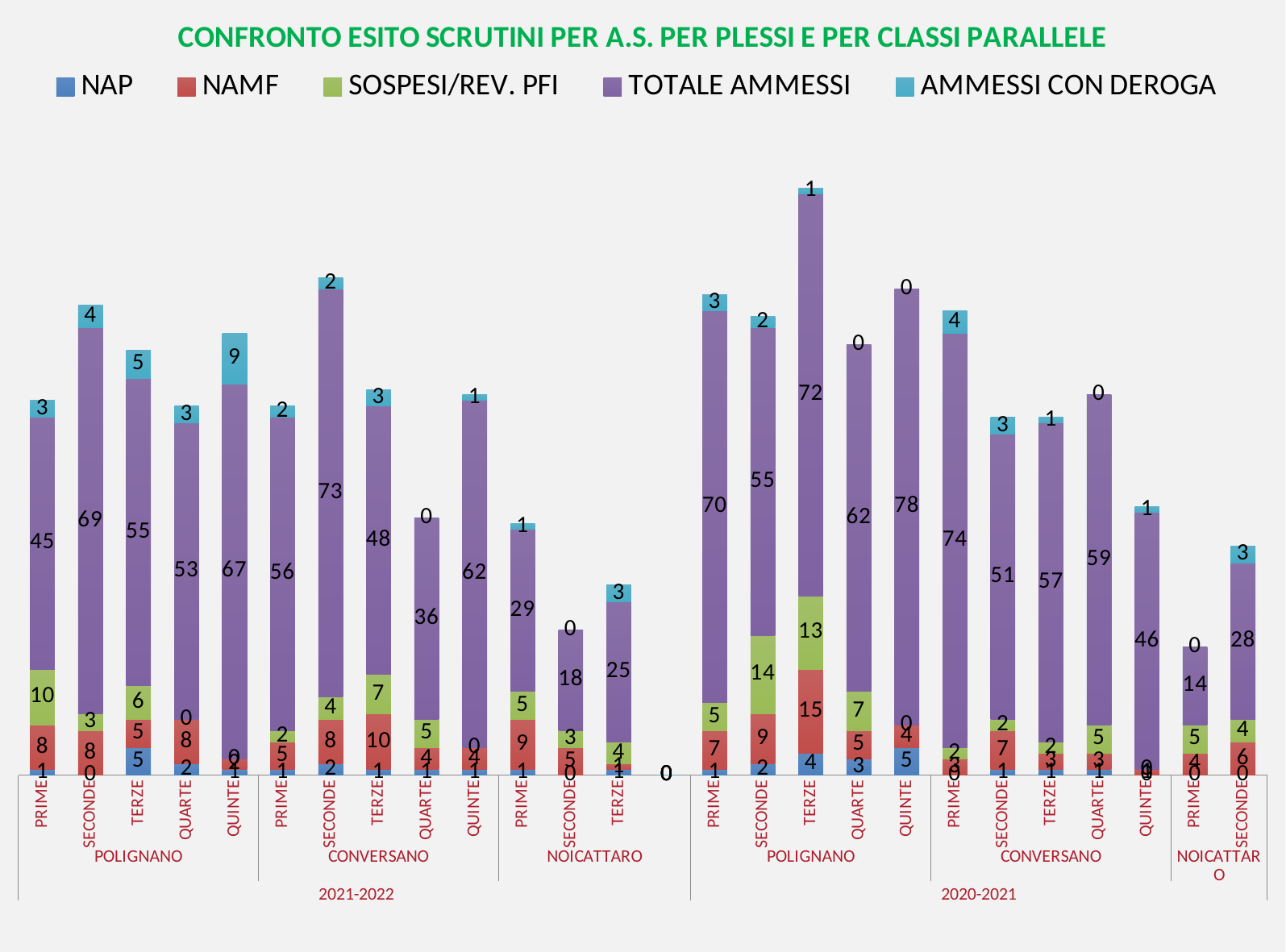
What is the AMMESSI CON DEROGA value for QUINTE in POLIGNANO for 2021-2022? 9 Which class and school has the highest TOTALE AMMESSI value across the whole chart? QUINTE, POLIGNANO, 2020-2021 What is the NAMF value for TERZE in POLIGNANO for 2020-2021? 15 What is the TOTALE AMMESSI value for QUINTE in POLIGNANO for 2020-2021? 78 Which has a larger TOTALE AMMESSI value: TERZE in CONVERSANO 2021-2022 or TERZE in CONVERSANO 2020-2021? TERZE in CONVERSANO 2020-2021 Which class and school has the lowest TOTALE AMMESSI value across the whole chart? PRIME, NOICATTARO, 2020-2021 What is the total of the stacked bar for TERZE in POLIGNANO for 2020-2021? 105 What is the difference between the TOTALE AMMESSI values for SECONDE in POLIGNANO in 2021-2022 and in 2020-2021? 14 How many series does the legend list? 5 What is the TOTALE AMMESSI value for SECONDE in CONVERSANO for 2021-2022? 73 What kind of chart is shown on the slide? Stacked bar chart What is the title of the chart? CONFRONTO ESITO SCRUTINI PER A.S. PER PLESSI E PER CLASSI PARALLELE